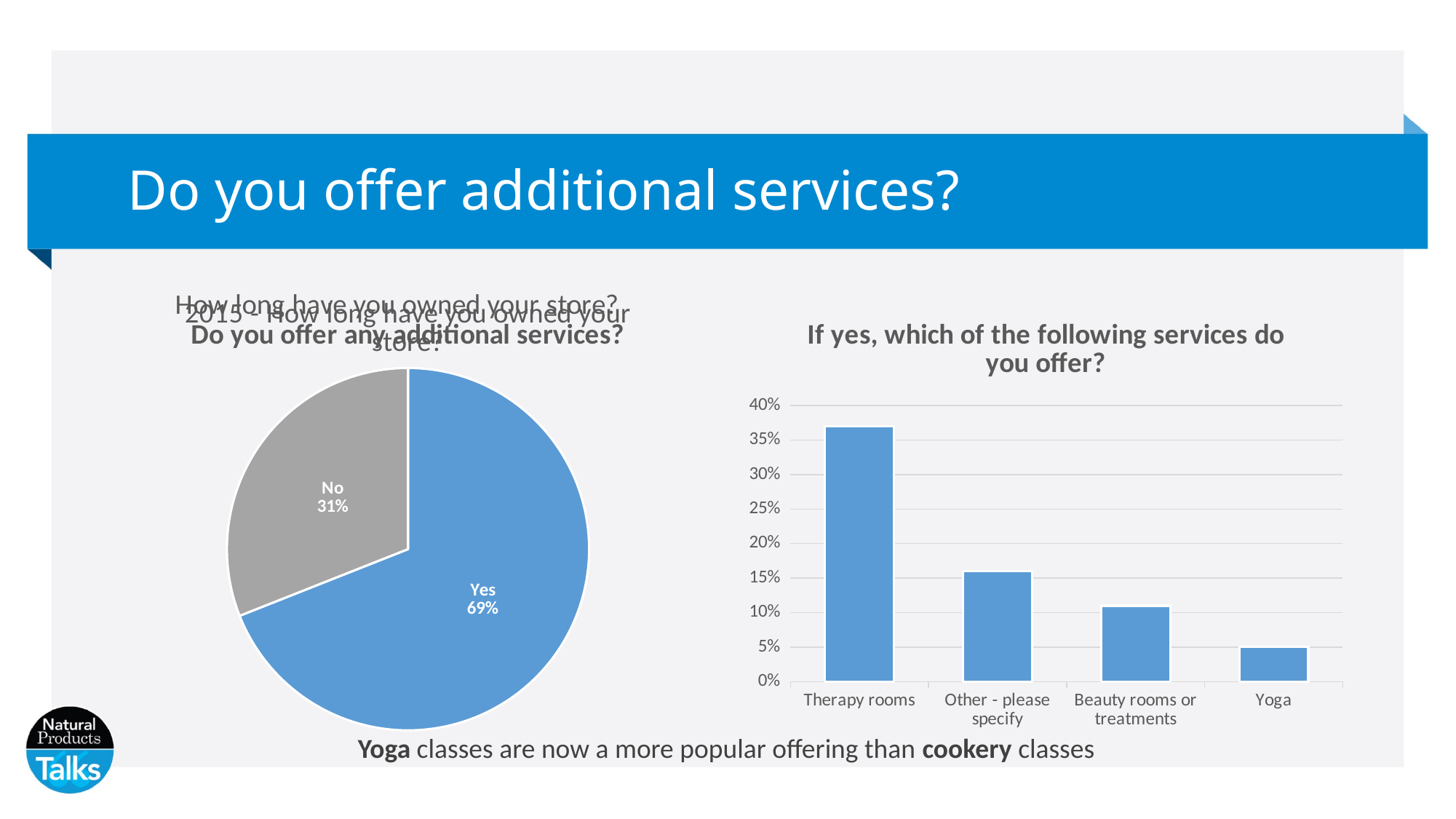
In the pie chart 'Do you offer any additional services?', what share of respondents answered Yes? 69% How many service categories are shown in the chart 'If yes, which of the following services do you offer?'? 4 In the chart 'If yes, which of the following services do you offer?', is the value for Yoga greater or less than 10%? less What type of chart is 'If yes, which of the following services do you offer?'? Bar chart In the chart 'If yes, which of the following services do you offer?', which service has the highest value? Therapy rooms What type of chart is the chart on the left of the slide? Pie chart In the pie chart 'Do you offer any additional services?', which slice is larger, Yes or No? Yes How many slices does the pie chart 'Do you offer any additional services?' have? 2 In the chart 'If yes, which of the following services do you offer?', which service has the lowest value? Yoga In the pie chart 'Do you offer any additional services?', what share of respondents answered No? 31% In the chart 'If yes, which of the following services do you offer?', is the value for Therapy rooms greater or less than 35%? greater In the pie chart 'Do you offer any additional services?', what is the difference in percentage points between the Yes and No slices? 38 percentage points